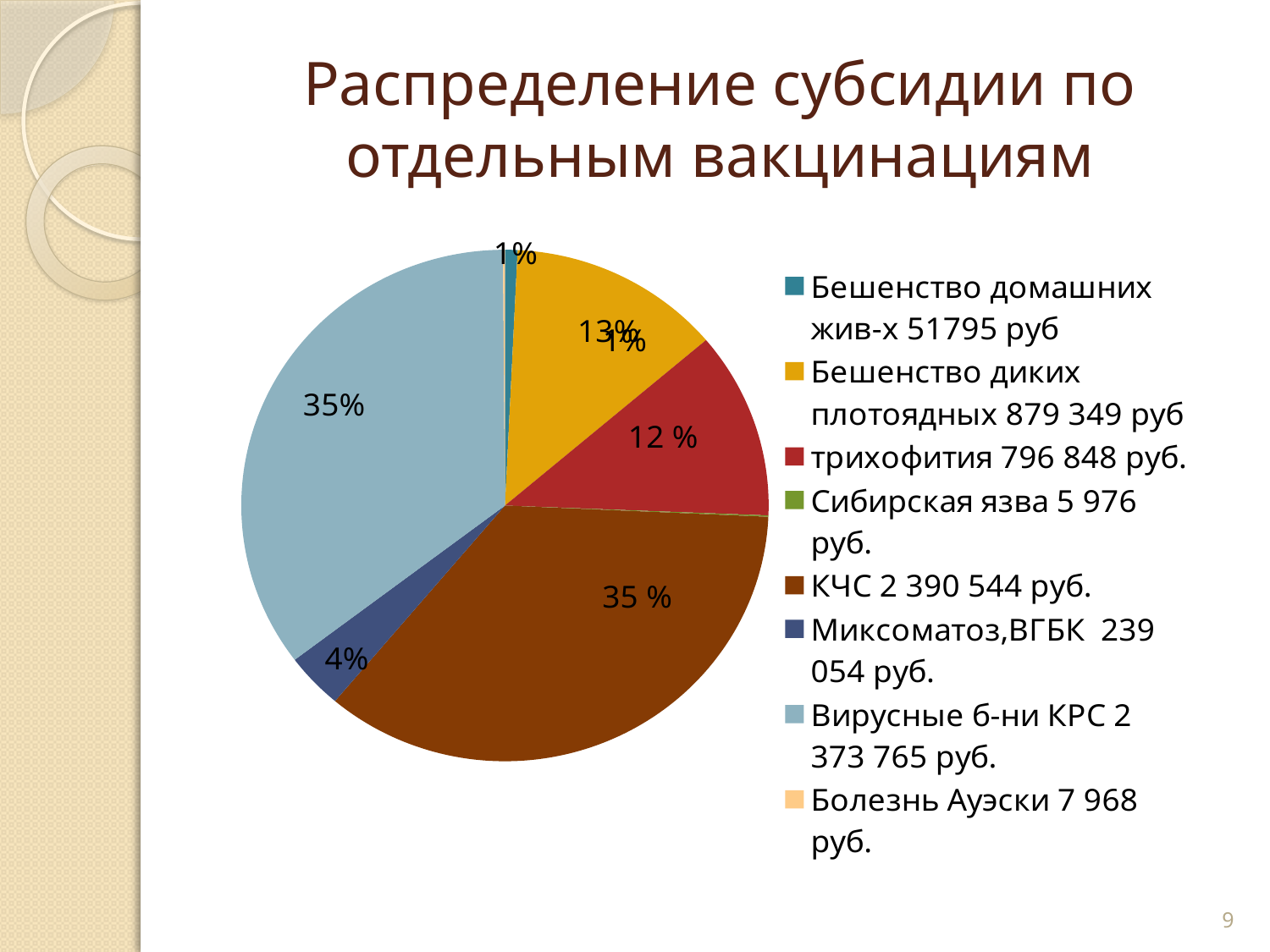
What share of the pie does the slice for Вирусные б-ни КРС have? 35% What share of the pie does the slice for трихофития have? 12 % What share of the pie does the slice for Бешенство диких плотоядных have? 13% Which slice is larger, КЧС or трихофития? КЧС How many entries does the legend of the pie chart list? 8 Which slice is larger, Бешенство диких плотоядных or Миксоматоз,ВГБК? Бешенство диких плотоядных What is the title of the chart? Распределение субсидии по отдельным вакцинациям What amount in rubles is given in the legend for КЧС? 2 390 544 руб. What kind of chart is shown on the slide? pie chart What is the difference in percentage points between the Бешенство диких плотоядных slice and the трихофития slice? 1